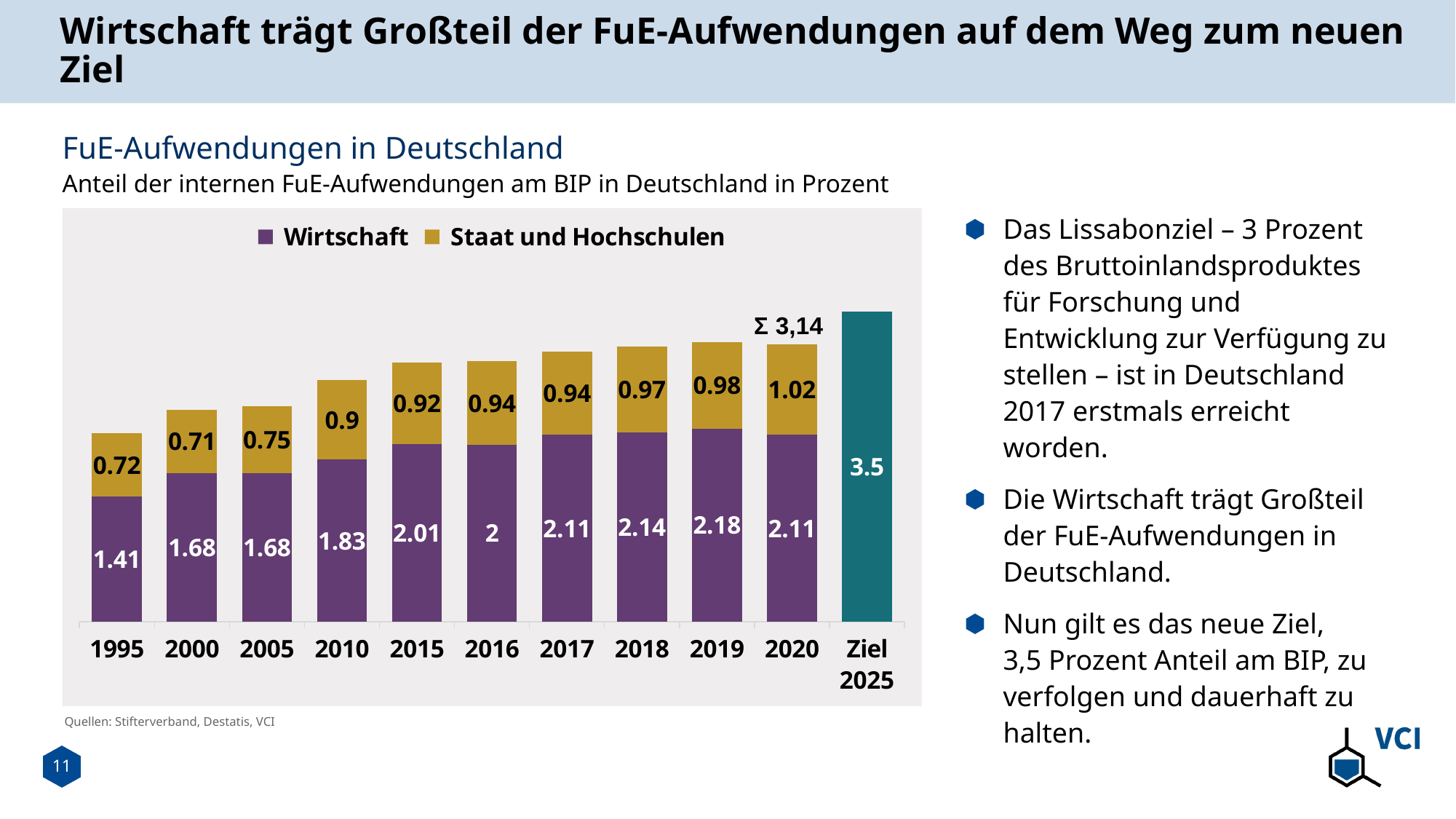
In which year is the Staat und Hochschulen value highest? 2020 In which year is the Wirtschaft value lowest? 1995 What total is printed above the 2020 bar? Σ 3,14 Which is larger, the Staat und Hochschulen value for 2010 or for 2015? 2015 In which year is the Wirtschaft value highest? 2019 What value is shown for the Ziel 2025 bar? 3.5 How many series does the legend list? 2 What is the difference between the Wirtschaft values for 2019 and 1995? 0.77 How many bars are shown on the x axis, including Ziel 2025? 11 What is the Wirtschaft value for 1995? 1.41 What is the Staat und Hochschulen value for 2018? 0.97 What kind of chart is shown? Stacked bar chart